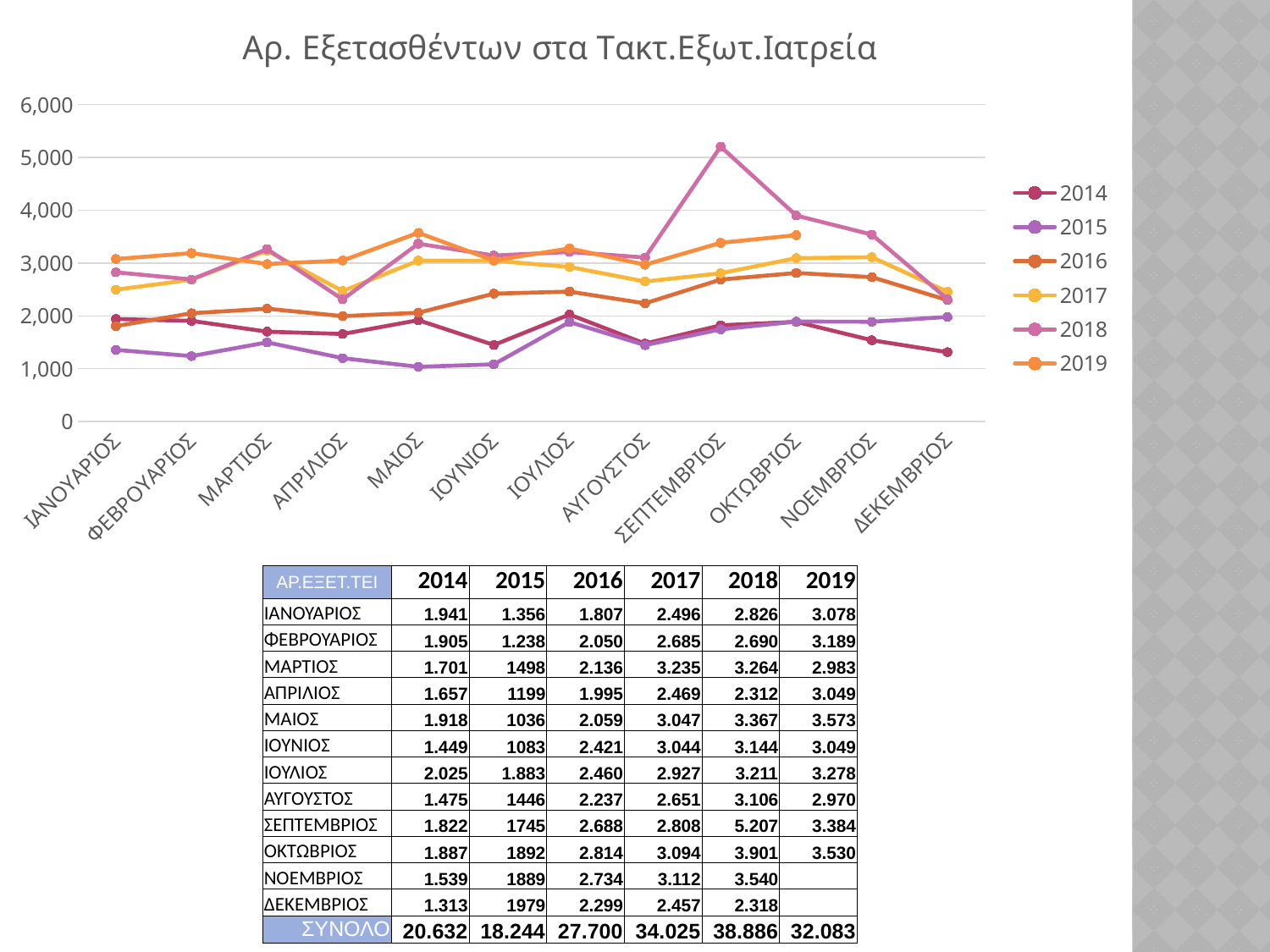
Is the value for 2018 in ΣΕΠΤΕΜΒΡΙΟΣ greater or less than 5,000? greater What is the value for 2014 in ΙΑΝΟΥΑΡΙΟΣ? 1.941 What kind of chart is shown on the slide? line chart What is the title of the chart? Αρ. Εξετασθέντων στα Τακτ.Εξωτ.Ιατρεία In which month does the 2015 series have its lowest value? ΜΑΙΟΣ In ΙΟΥΛΙΟΣ, which series has the larger value, 2016 or 2017? 2017 What is the value for 2018 in ΣΕΠΤΕΜΒΡΙΟΣ? 5.207 In which month does the 2018 series reach its highest value? ΣΕΠΤΕΜΒΡΙΟΣ How many months are plotted along the x axis of the chart? 12 How many series does the legend of the chart list? 6 What is the difference between the 2019 and 2014 values in ΜΑΙΟΣ? 1.655 Does the 2014 series rise or fall from ΟΚΤΩΒΡΙΟΣ to ΔΕΚΕΜΒΡΙΟΣ? fall